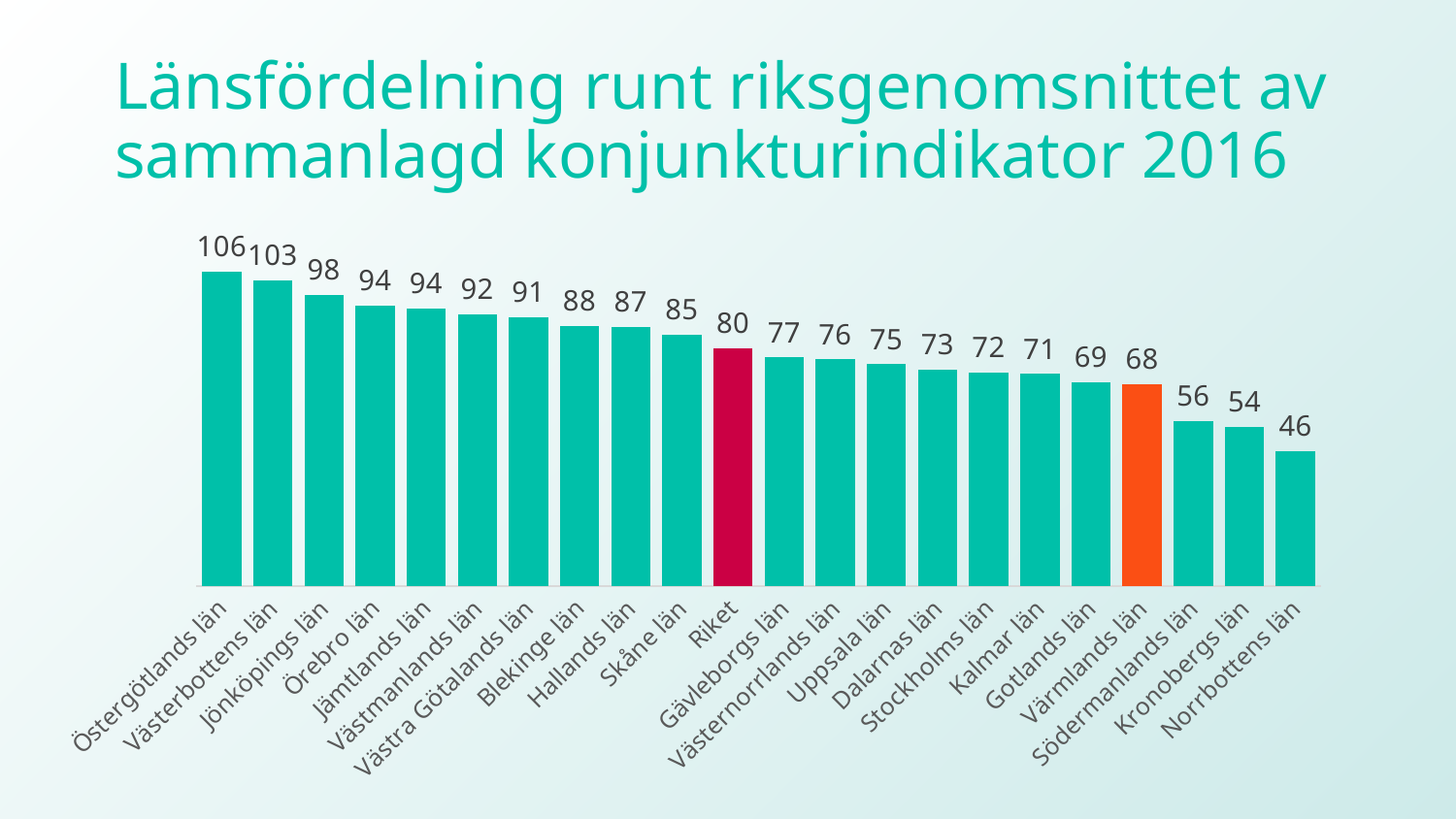
What is the value for Värmlands län? 68 Which category has the highest value? Östergötlands län What is the value for Riket? 80 Which has a larger value, Uppsala län or Gotlands län? Uppsala län What is the value for Stockholms län? 72 What is the difference between the values for Östergötlands län and Norrbottens län? 60 What is the difference between the values for Skåne län and Riket? 5 Which category has the lowest value? Norrbottens län Which bar is coloured red? Riket What kind of chart is shown on the slide? Bar chart Do the values rise or fall from left to right along the x axis? Fall How many bars are shown in the chart? 22